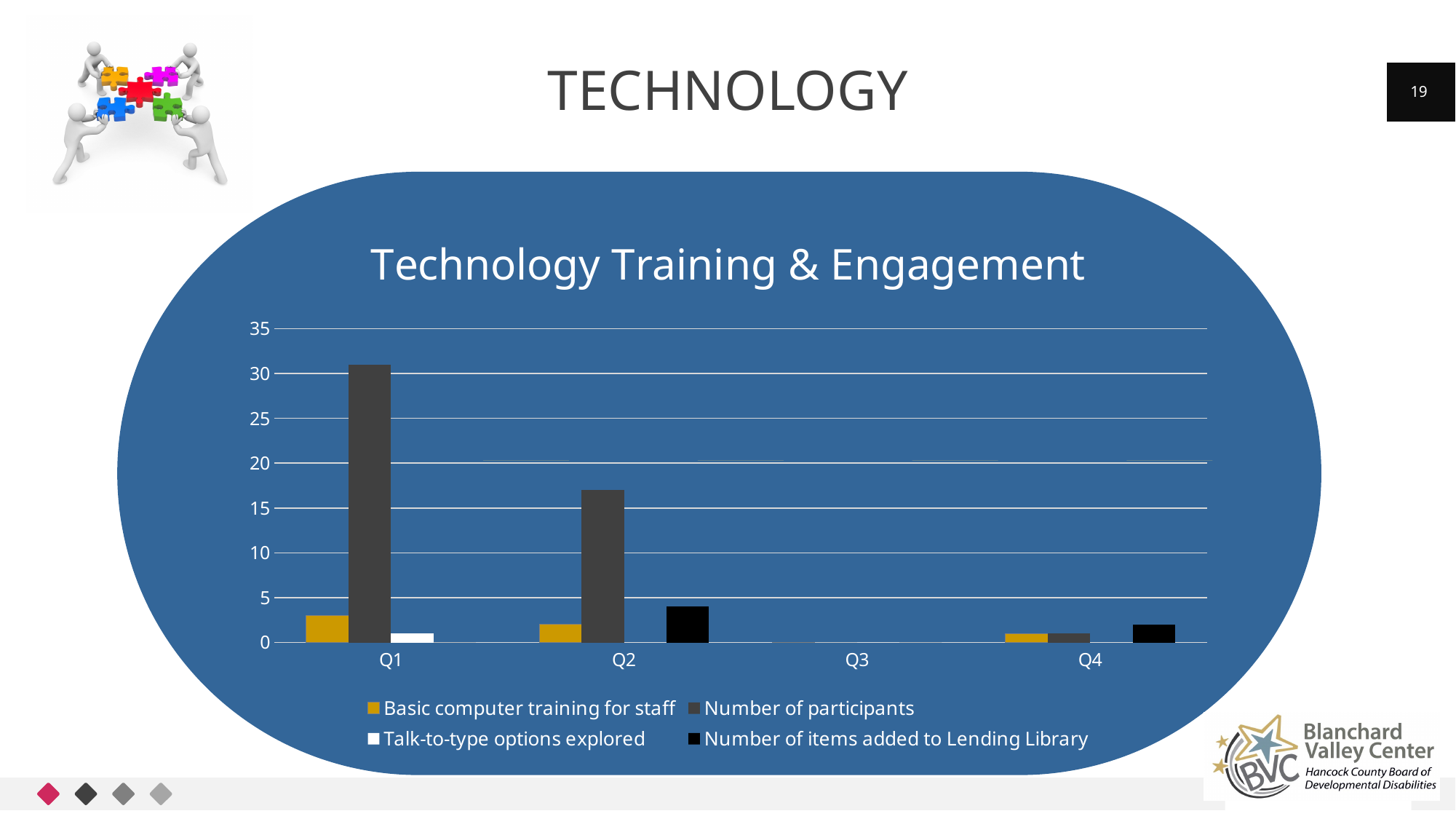
Does the Number of participants rise or fall from Q1 to Q2? fall Is the value for Number of participants in Q2 greater or less than 20? less Which is larger: Number of items added to Lending Library in Q2 or in Q4? Q2 Which quarter has the highest value for Number of participants? Q1 Which series is shown in gold/yellow in the legend? Basic computer training for staff Is the value for Number of participants in Q1 greater or less than 25? greater How many series does the legend list? 4 How many quarters are shown on the x axis? 4 Is the value for Number of participants in Q2 greater or less than 15? greater What is the title of the chart? Technology Training & Engagement Which is larger: Number of participants in Q1 or in Q2? Q1 What kind of chart is shown on the slide? bar chart